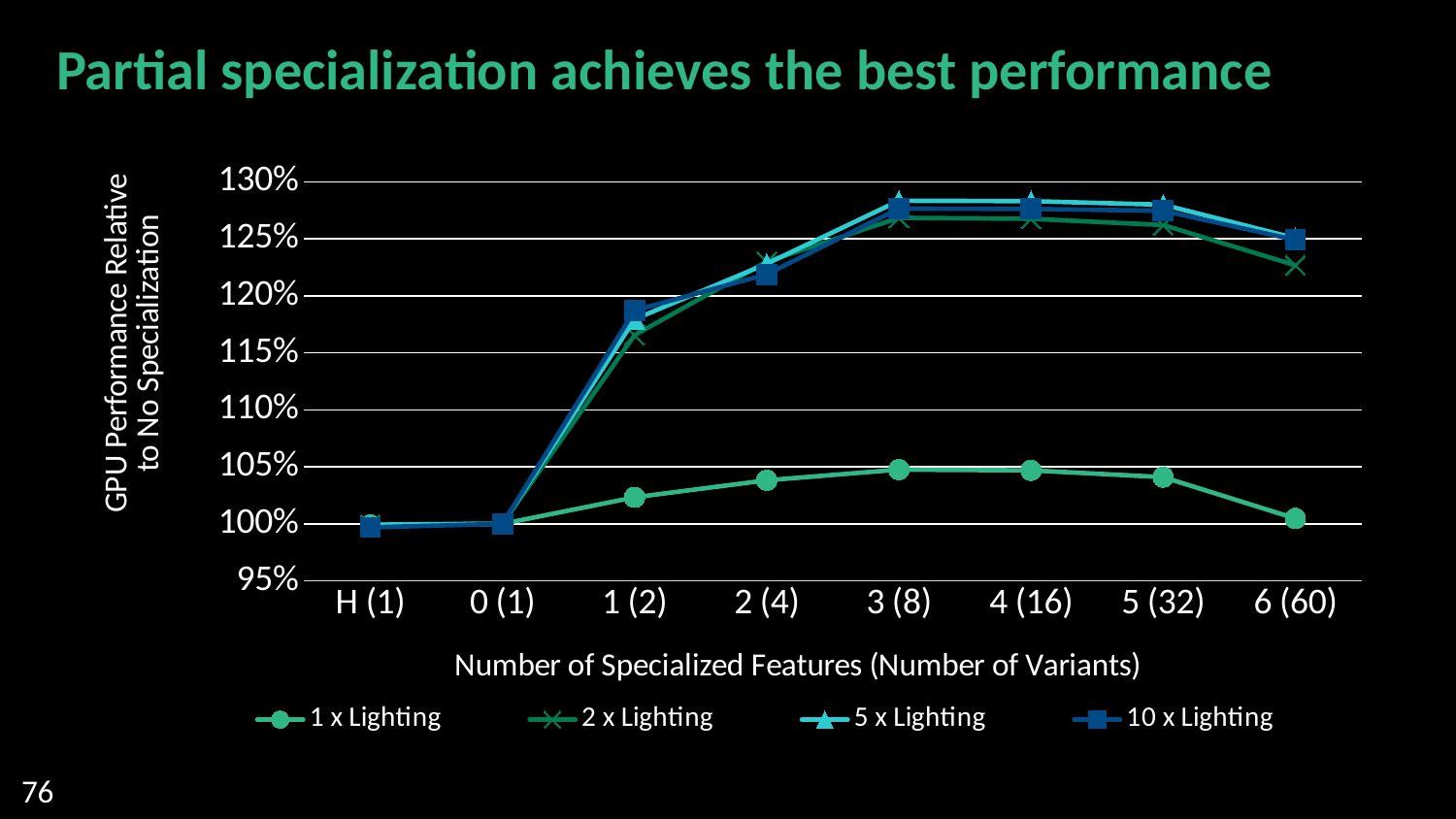
How many categories are shown along the x axis? 8 Is the value for 10 x Lighting at 1 (2) greater or less than 115%? greater Does the 1 x Lighting series rise or fall from 4 (16) to 6 (60)? fall What is the label of the y axis? GPU Performance Relative to No Specialization Is the value for 2 x Lighting at 6 (60) greater or less than 120%? greater Is the value for 1 x Lighting at 6 (60) greater or less than 105%? less At 1 (2), which series has the larger value: 1 x Lighting or 10 x Lighting? 10 x Lighting How many series does the legend list? 4 What kind of chart is shown on the slide? line chart What is the value for 10 x Lighting at O (1)? 100% At 6 (60), which series has the larger value: 5 x Lighting or 2 x Lighting? 5 x Lighting